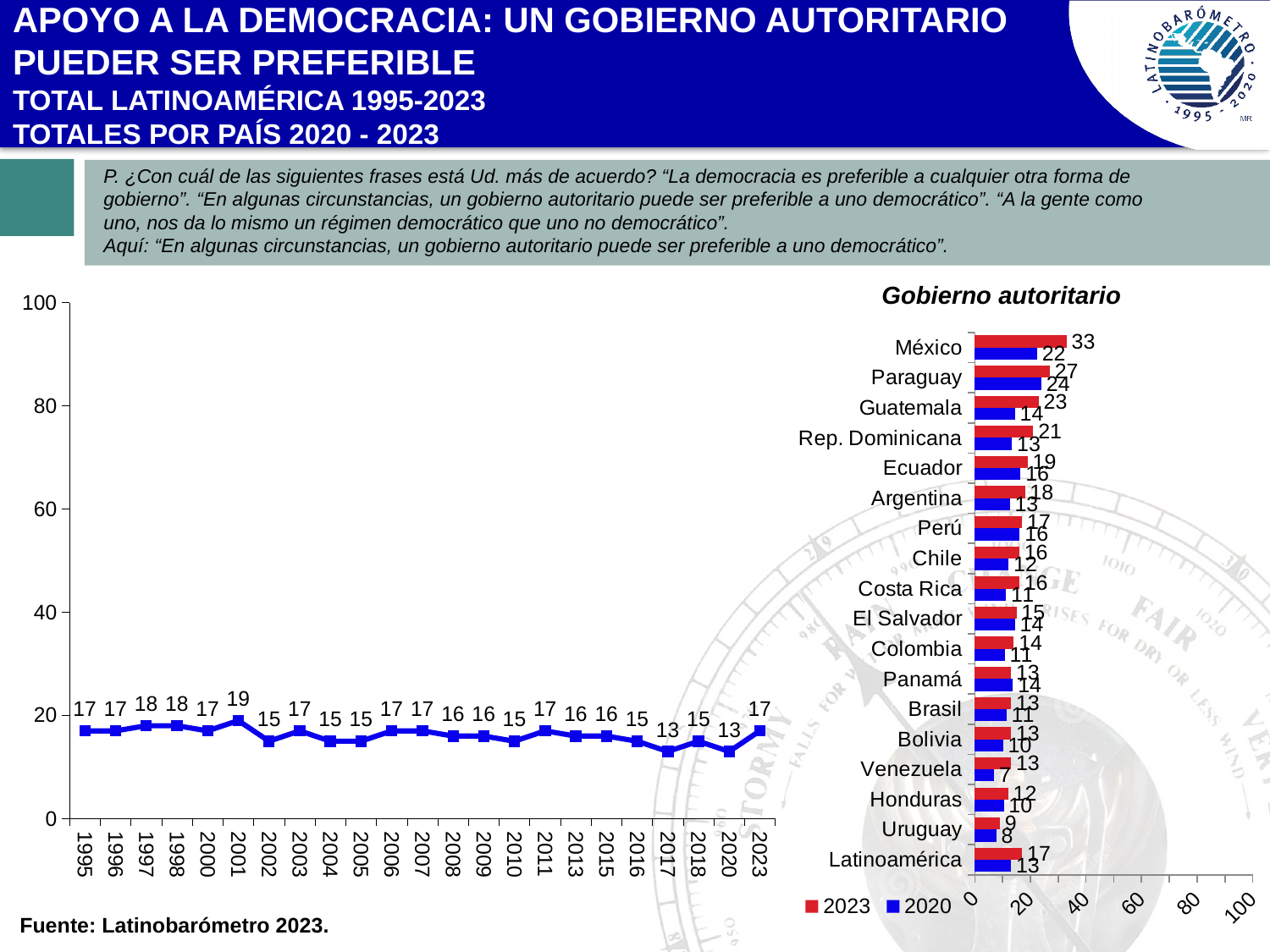
In the 'Gobierno autoritario' chart, which country has the lowest 2023 value? Uruguay In the 'Gobierno autoritario' chart, what is the 2020 value for Venezuela? 7 In the 'Gobierno autoritario' chart, which colour represents 2023? Red In the line chart on the left, what is the value for 2001? 19 In the 'Gobierno autoritario' chart, what is the 2023 value for México? 33 What kind of chart is the chart on the left? Line chart In the 'Gobierno autoritario' chart, which is larger for Panamá: the 2023 value or the 2020 value? 2020 In the 'Gobierno autoritario' chart, what is the difference between the 2023 and 2020 values for México? 11 In the line chart on the left, how many data points are plotted? 23 In the line chart on the left, what is the difference between the 2023 value and the 2020 value? 4 In the 'Gobierno autoritario' chart, how many series does the legend list? 2 In the line chart on the left, which year has the lowest value? 2017 and 2020 (both 13)